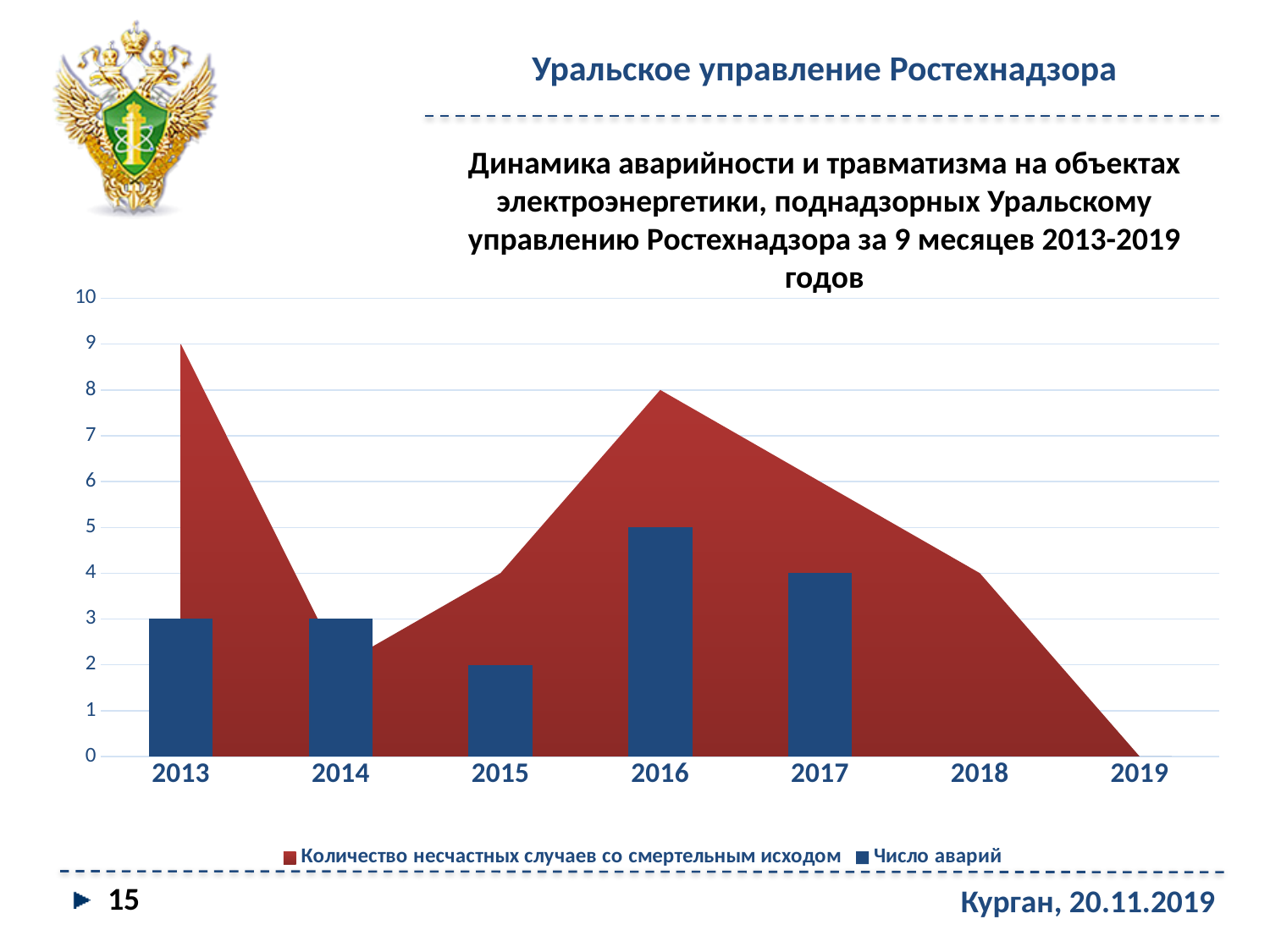
Is the value of "Количество несчастных случаев со смертельным исходом" for 2016 greater or less than 5? greater What is the value of "Число аварий" for 2016? 5 Does "Количество несчастных случаев со смертельным исходом" rise or fall from 2016 to 2019? fall What kind of chart is shown on the slide? A combined bar and area chart What is the value of "Число аварий" for 2015? 2 What is the value of "Количество несчастных случаев со смертельным исходом" for 2013? 9 How many years are shown on the x axis? 7 In which year is "Количество несчастных случаев со смертельным исходом" highest? 2013 Which year has the larger value of "Число аварий", 2016 or 2017? 2016 How many series does the legend list? 2 What is the difference between "Число аварий" in 2016 and in 2015? 3 In which year is "Число аварий" highest? 2016